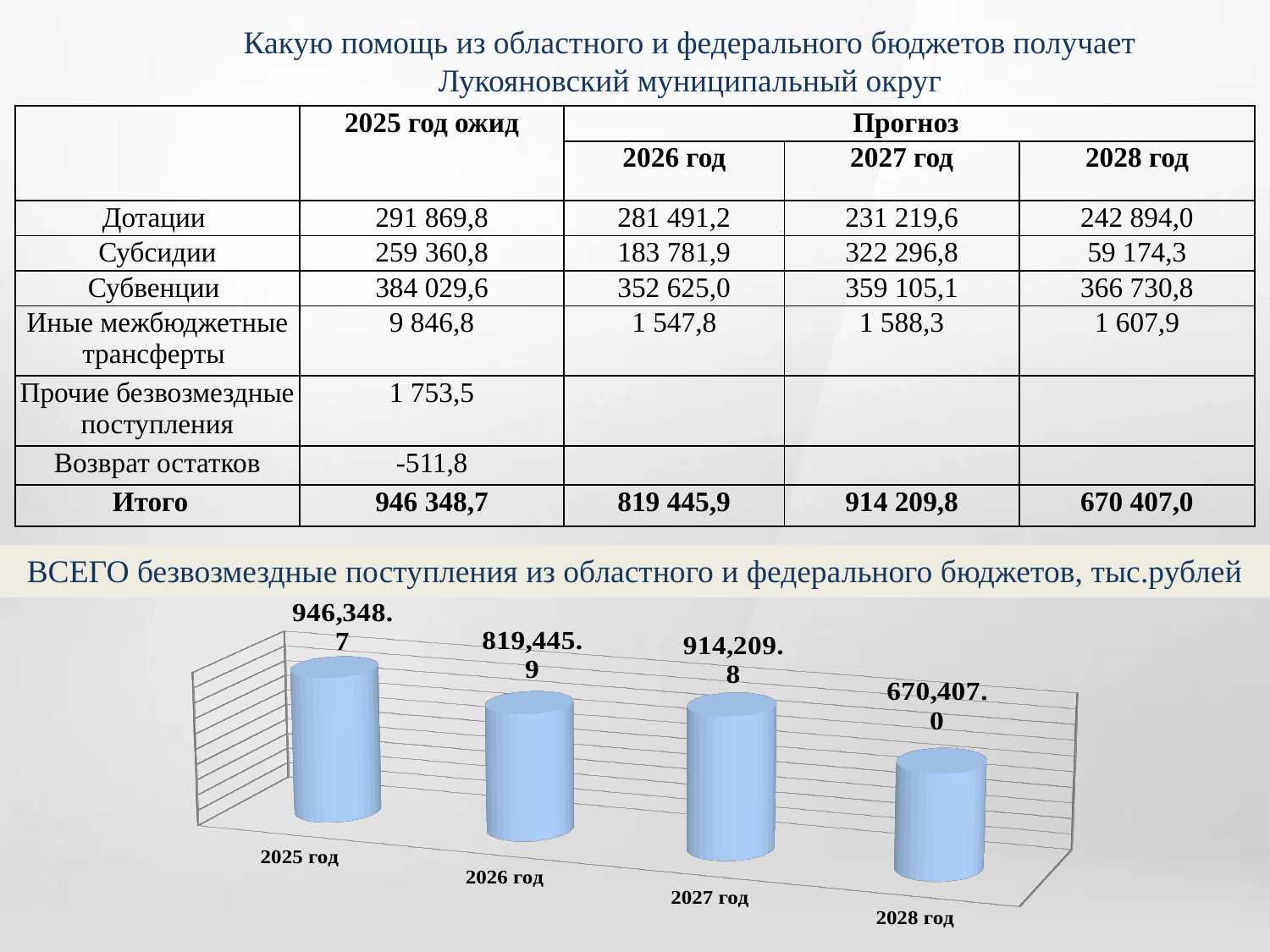
Which year has the highest value in the chart? 2025 год What is the value for 2026 год in the chart? 819,445.9 Which year has the lowest value in the chart? 2028 год What is the value for 2028 год in the chart? 670,407.0 Does the value rise or fall from 2027 год to 2028 год in the chart? fall What kind of chart is shown on the slide? bar chart What is the difference between the values for 2025 год and 2026 год in the chart? 126,902.8 What is the value for 2025 год in the chart? 946,348.7 How many years are shown in the chart? 4 Which is larger in the chart, the value for 2026 год or the value for 2027 год? 2027 год What is the difference between the values for 2027 год and 2028 год in the chart? 243,802.8 What is the value for 2027 год in the chart? 914,209.8